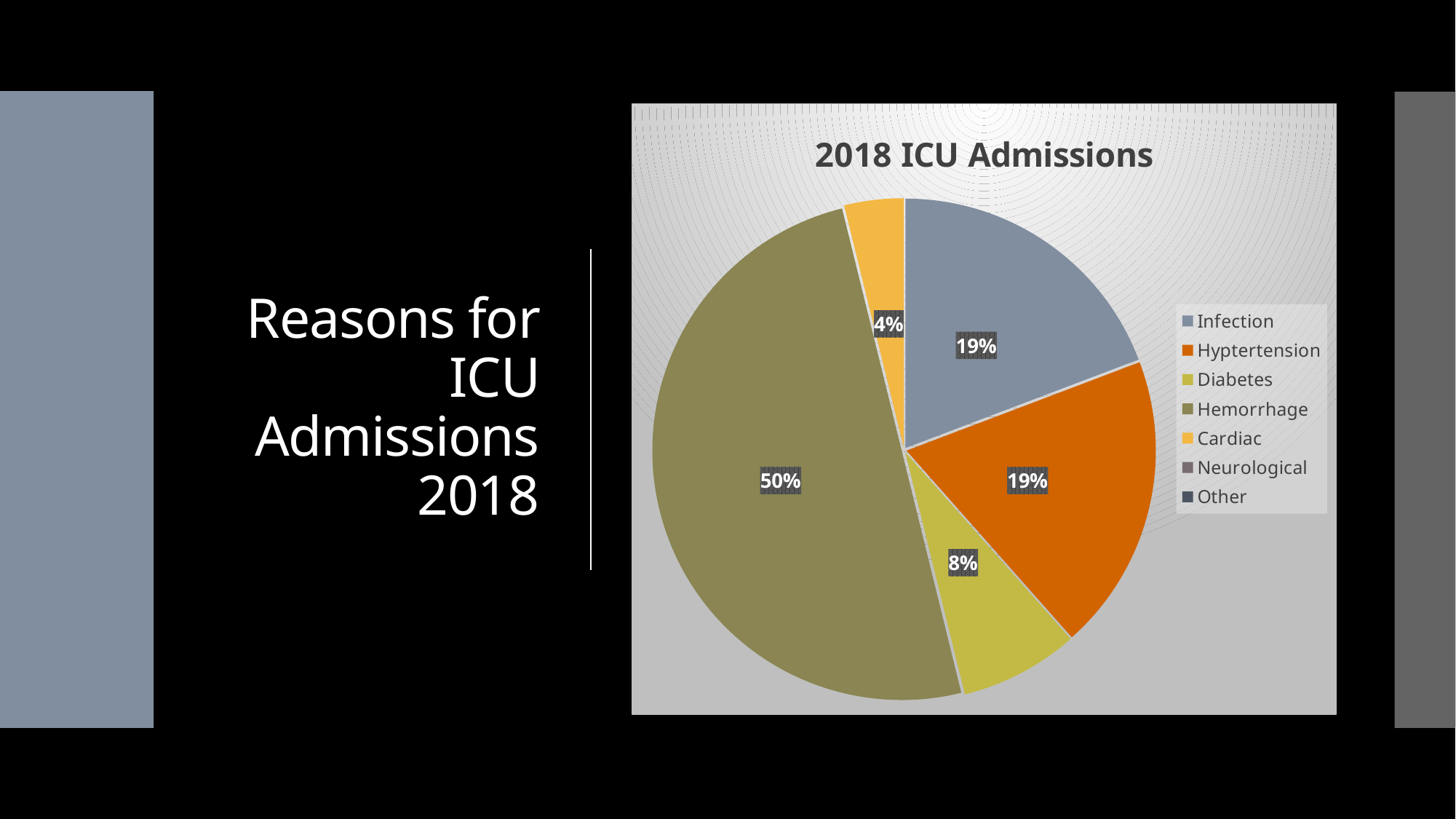
What percentage of 2018 ICU admissions is attributed to Hemorrhage? 50% Which of the labeled slices is the smallest? Cardiac How many categories are listed in the chart's legend? 7 What percentage of 2018 ICU admissions is attributed to Diabetes? 8% What percentage of 2018 ICU admissions is attributed to Cardiac? 4% How many slices have a percentage label shown on the pie? 5 Which category accounts for the largest share of 2018 ICU admissions? Hemorrhage What is the difference in percentage points between the Hemorrhage slice and the Infection slice? 31% What is the title of the chart? 2018 ICU Admissions What type of chart is shown on the slide? pie chart What percentage of 2018 ICU admissions is attributed to Infection? 19% Which is larger, the Hemorrhage slice or the Hyptertension slice? Hemorrhage